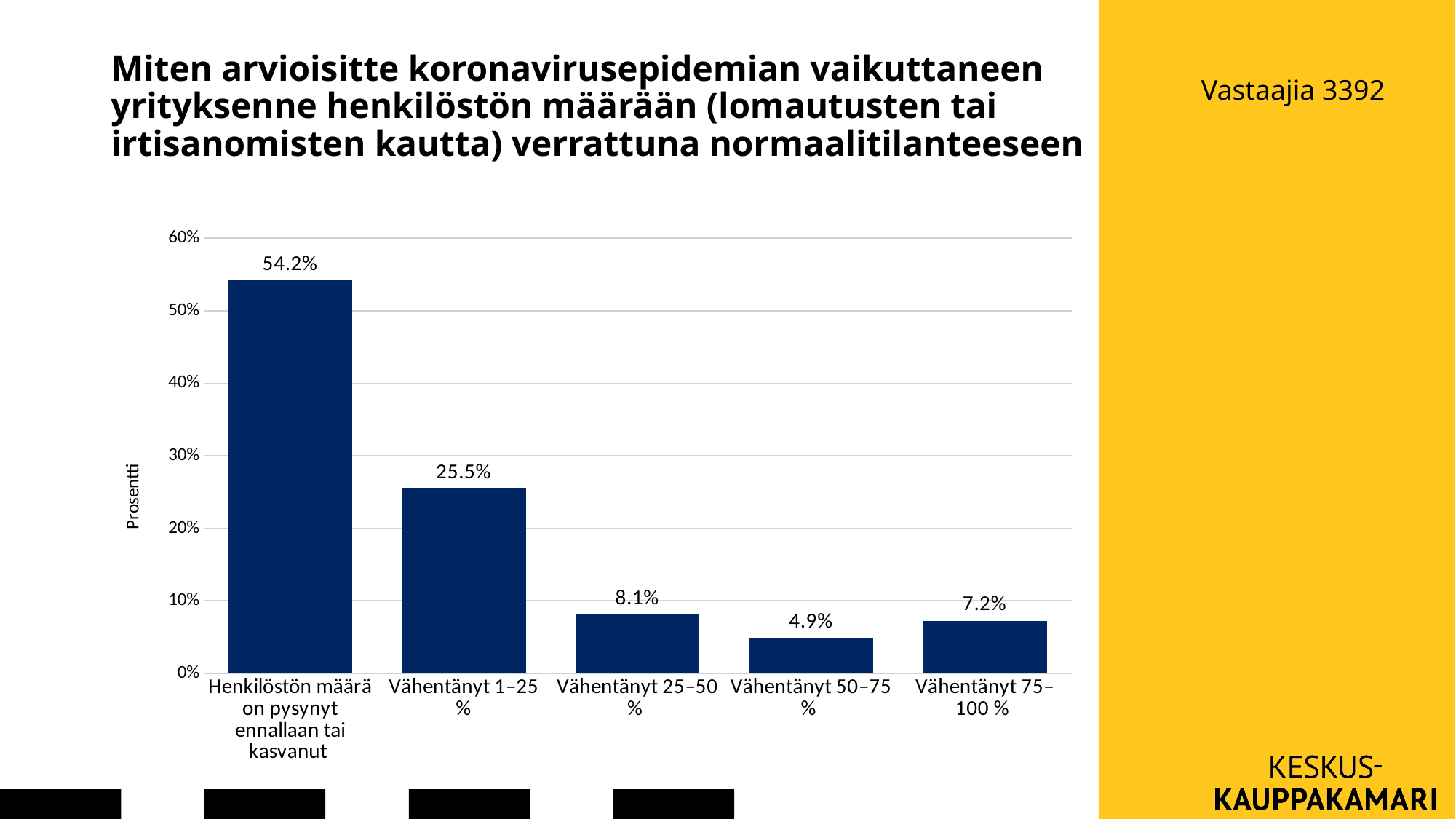
What is the difference between the values for "Vähentänyt 1–25 %" and "Vähentänyt 25–50 %"? 17.4% Which category has the lowest value? Vähentänyt 50–75 % What is the label of the vertical axis? Prosentti What is the value for "Vähentänyt 25–50 %"? 8.1% What is the value for "Vähentänyt 75–100 %"? 7.2% Which is larger, the value for "Vähentänyt 25–50 %" or "Vähentänyt 75–100 %"? Vähentänyt 25–50 % How many categories are shown on the x axis? 5 What kind of chart is shown on the slide? bar chart What is the value for "Henkilöstön määrä on pysynyt ennallaan tai kasvanut"? 54.2% Is the value for "Vähentänyt 50–75 %" greater or less than 10%? less What is the value for "Vähentänyt 1–25 %"? 25.5% Which category has the highest value? Henkilöstön määrä on pysynyt ennallaan tai kasvanut